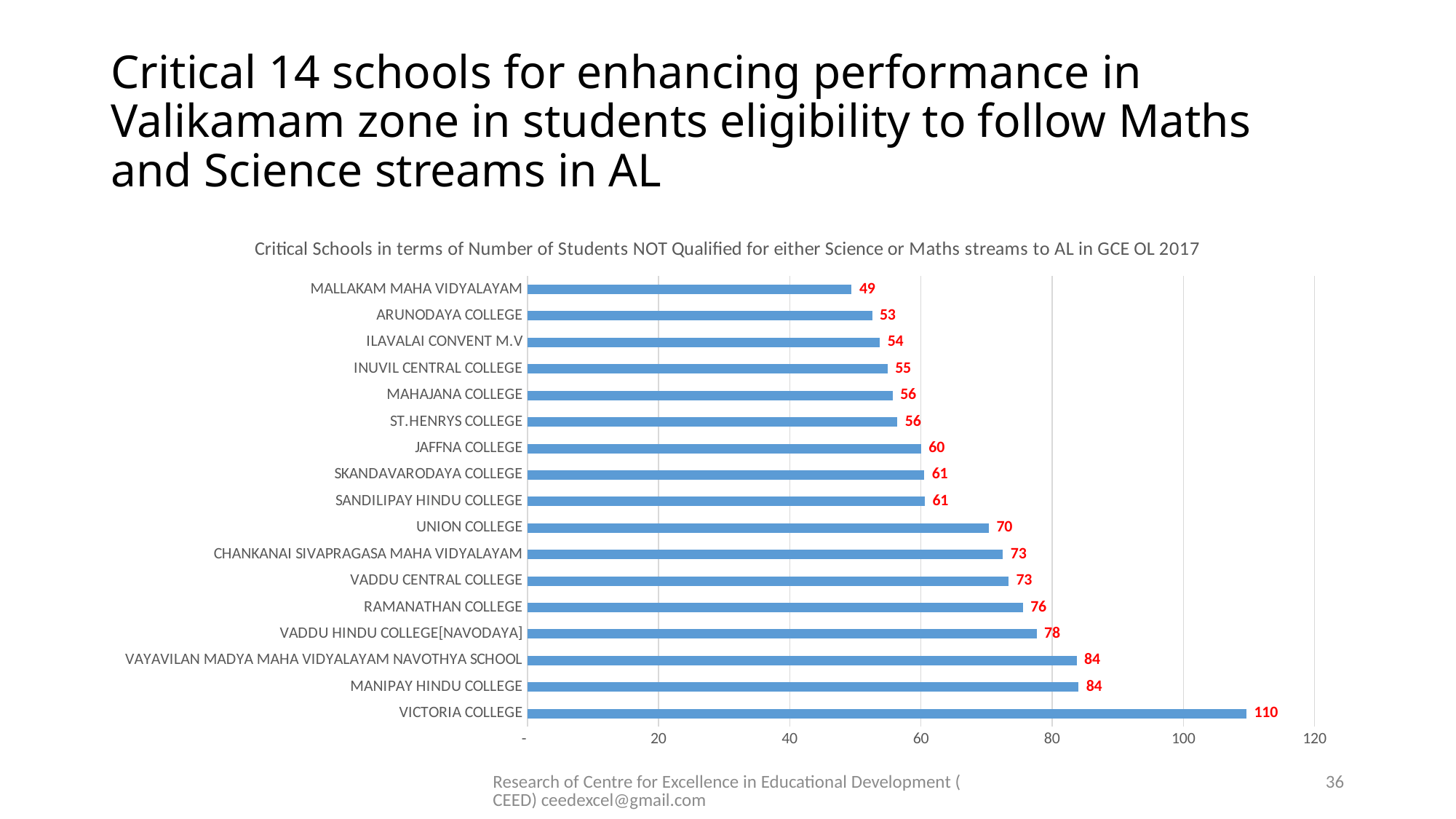
What is the value for Union College? 70 What kind of chart is shown on the slide? bar chart What is the value for Victoria College? 110 Which school has the lowest value? Mallakam Maha Vidyalayam What is the difference between the values for Vaddu Central College and Mallakam Maha Vidyalayam? 24 How many schools are shown in the chart? 17 Which is larger, the value for Ramanathan College or the value for Arunodaya College? Ramanathan College What is the difference between the values for Victoria College and Manipay Hindu College? 26 What is the value for Jaffna College? 60 What is the title of the chart? Critical Schools in terms of Number of Students NOT Qualified for either Science or Maths streams to AL in GCE OL 2017 Which school has the highest value? Victoria College Is the value for Vaddu Hindu College[Navodaya] greater or less than 60? greater